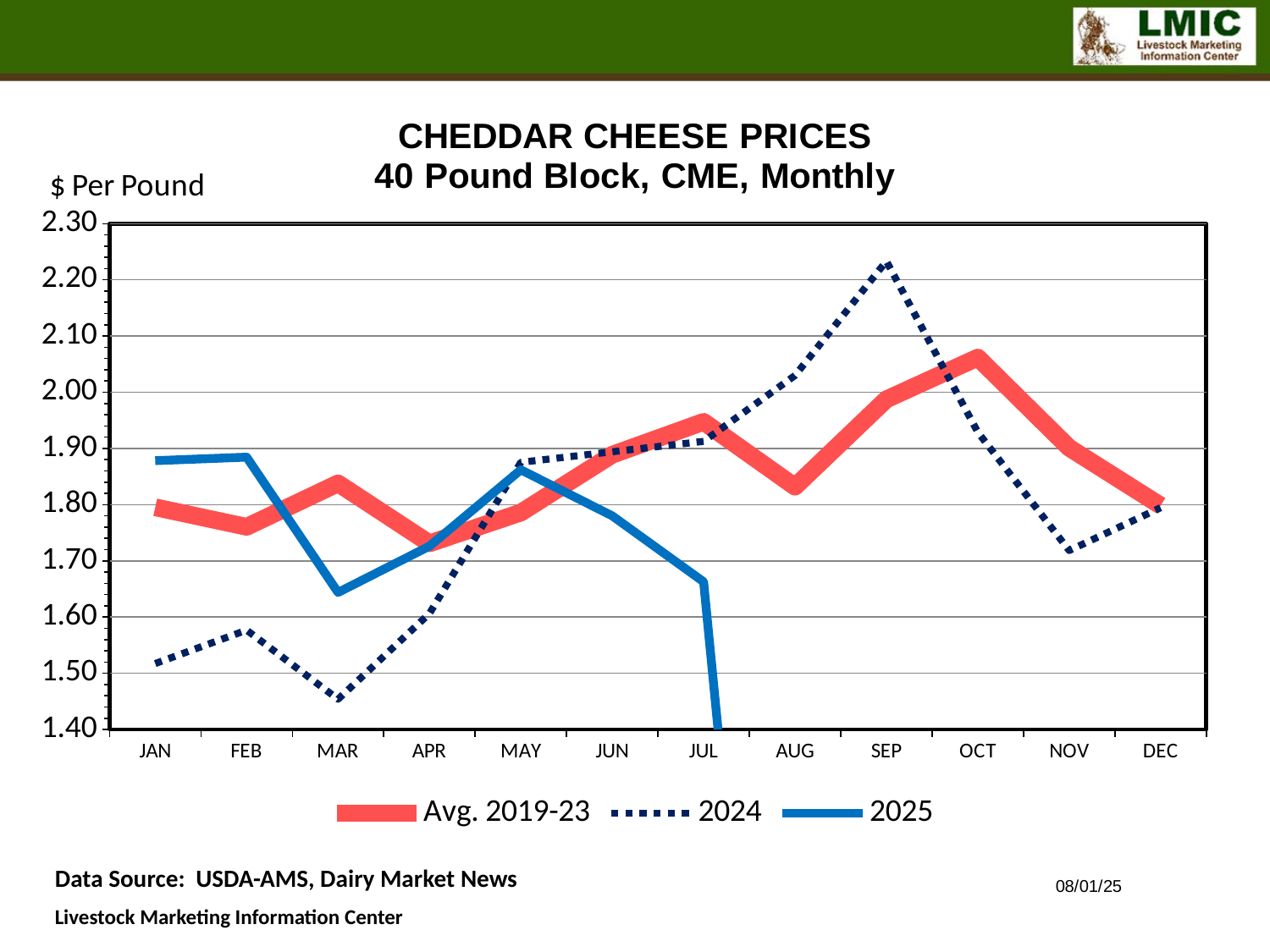
How many series does the legend list? 3 What kind of chart is shown on the slide? line chart Between MAY and SEP, does the 2024 line rise or fall? rise In which month does the 2024 line reach its highest value? SEP Is the 2024 value for SEP greater or less than 2.10? greater In JAN, which series has the higher value, 2025 or Avg. 2019-23? 2025 In which month does the 2024 line reach its lowest value? MAR Is the 2025 value for MAR greater or less than 1.70? less Is the 2024 value for MAR greater or less than 1.50? less How many months are shown along the x axis? 12 In which month does the Avg. 2019-23 line reach its highest value? OCT What is the label on the y axis? $ Per Pound